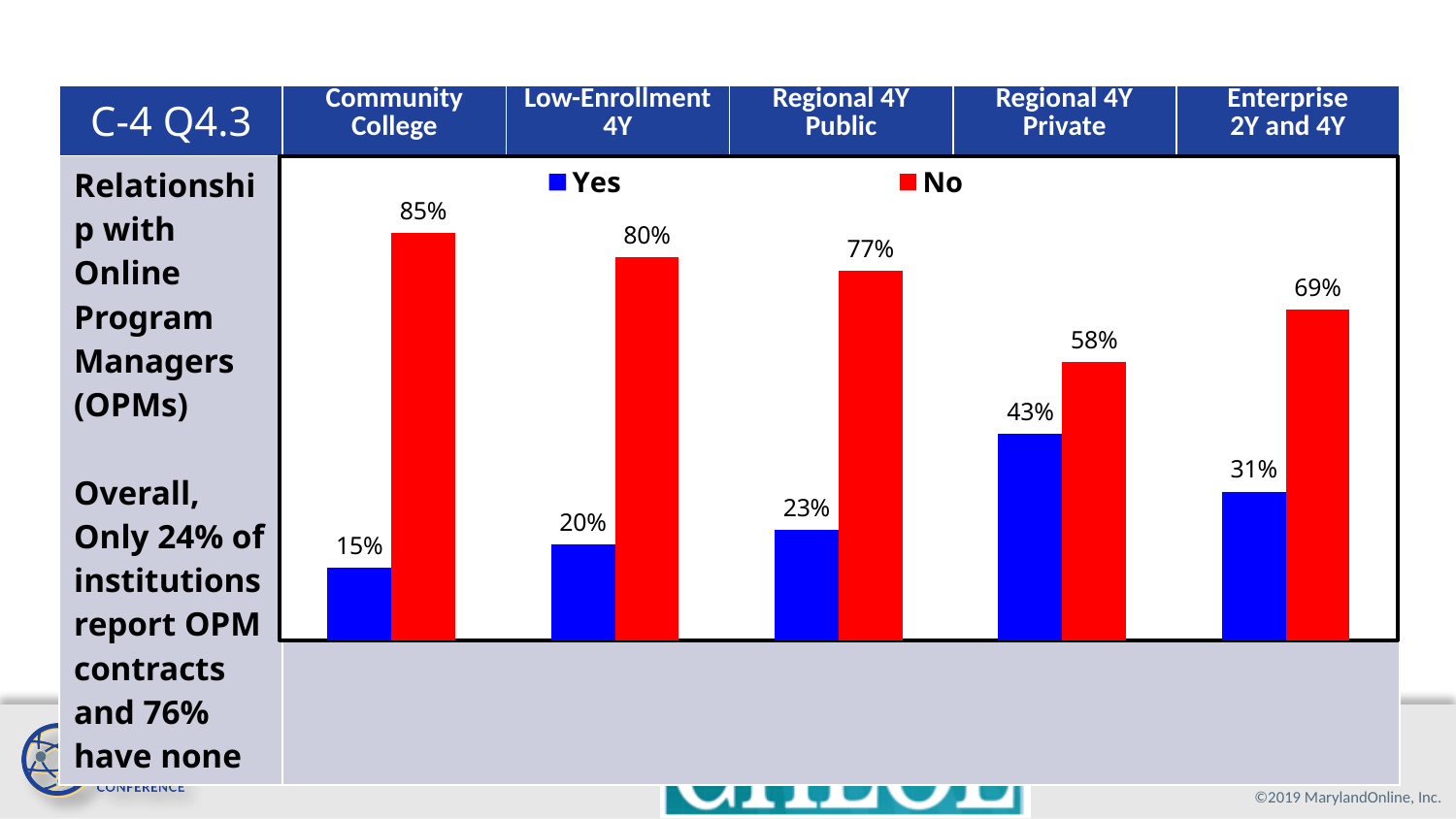
Which is larger: the Yes value for Regional 4Y Private or the Yes value for Regional 4Y Public? Regional 4Y Private Do the Yes values rise or fall from Community College to Regional 4Y Private? Rise What kind of chart is shown on the slide? Bar chart Which category has the lowest Yes value? Community College How many series does the legend list? 2 How many categories are shown in the chart? 5 What colour represents the No series in the chart? Red What is the difference between the No and Yes values for Low-Enrollment 4Y? 60% What is the Yes value for Enterprise 2Y and 4Y institutions? 31% Which category has the highest No value? Community College What percentage of Regional 4Y Private institutions answered No? 58% What percentage of Community College institutions answered Yes? 15%